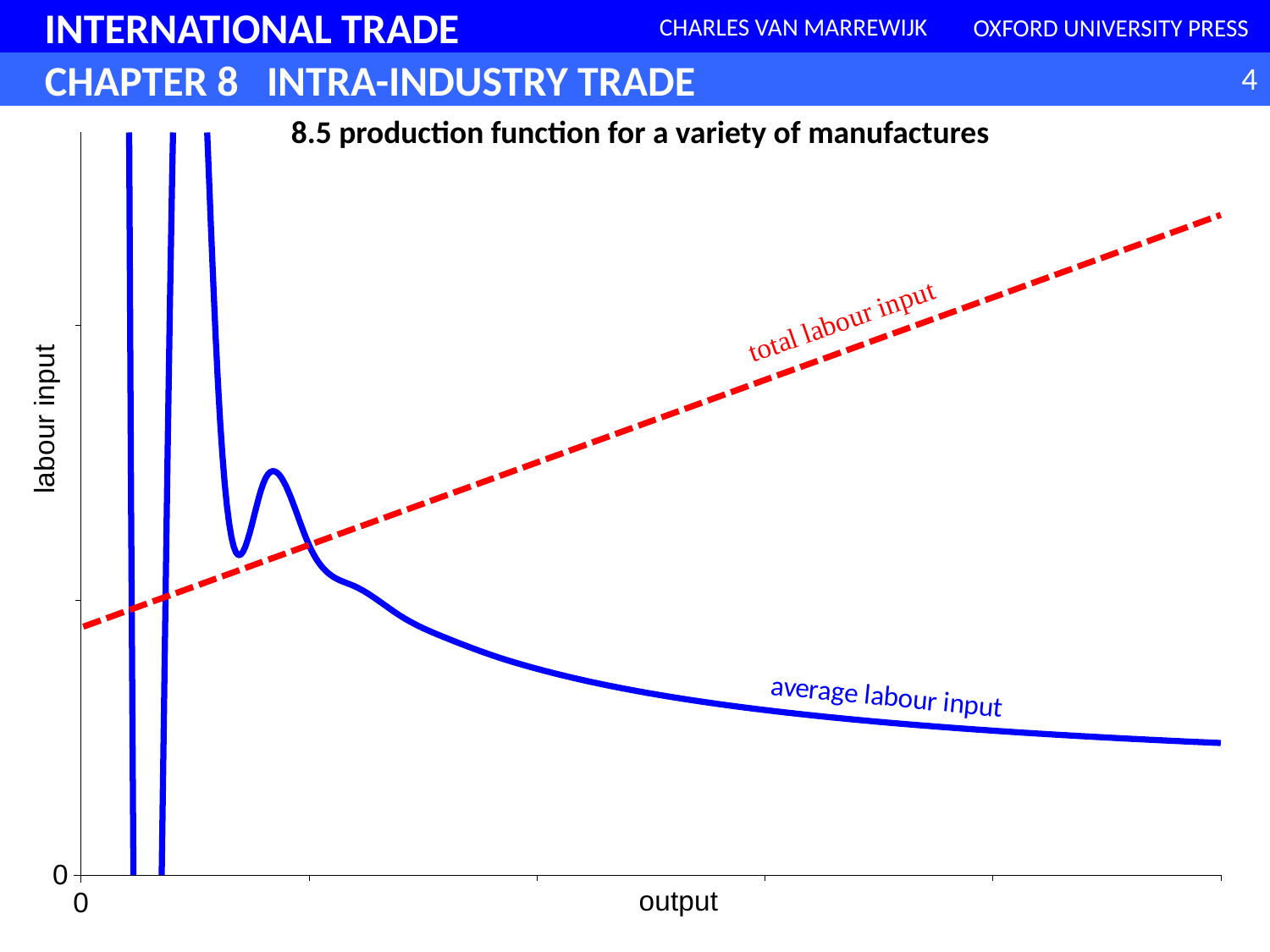
What is the label on the vertical axis of the chart? labour input What value is printed at the origin of the axes? 0 Does the 'total labour input' curve rise or fall as output increases? rise What kind of chart is shown on the slide? line chart What is the title of the chart? 8.5 production function for a variety of manufactures Which curve is drawn as a solid blue line? average labour input At the right-hand end of the chart, which curve is higher: 'total labour input' or 'average labour input'? total labour input Does the 'average labour input' curve rise or fall as output increases over the right-hand part of the chart? fall How many curves are plotted on the chart? 2